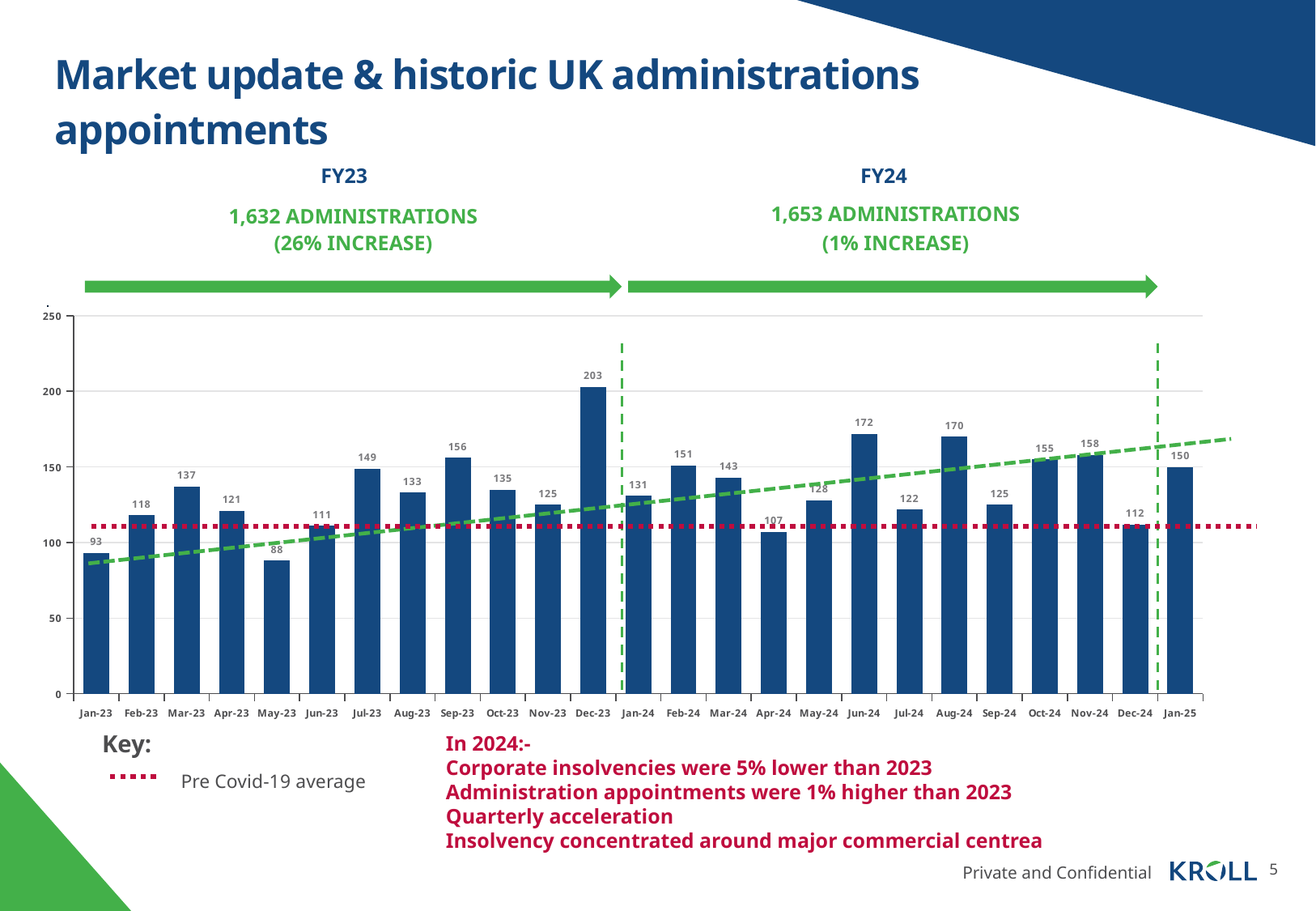
Which month has the lowest value? May-23 How many monthly bars are plotted on the chart? 25 What kind of chart is shown on the slide? Bar chart Which is larger, the value for Aug-24 or the value for Sep-24? Aug-24 What is the value for Jan-25? 150 What is the difference between the values for Dec-23 and Jan-24? 72 What does the red dotted line on the chart represent, according to the key? Pre Covid-19 average Which month has the highest value? Dec-23 What is the value for Jun-24? 172 What is the value for Dec-23? 203 Is the value for Apr-24 greater or less than 150? less What is the value for May-23? 88